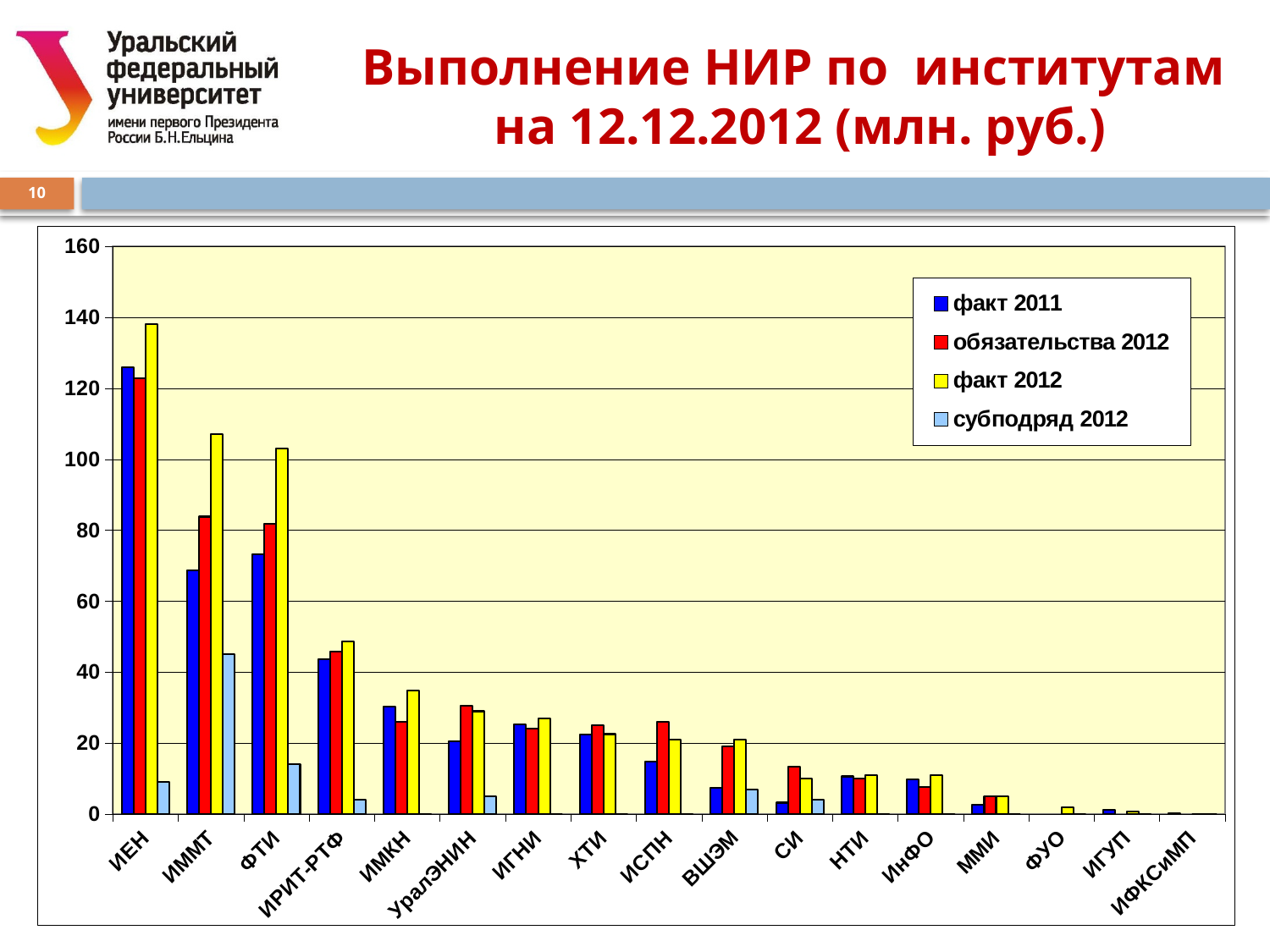
Which institute has the highest value for факт 2011? ИЕН Which institute has the highest value for факт 2012? ИЕН Is the факт 2012 value for ИЕН greater or less than 120? greater What colour represents the факт 2012 series in the legend? yellow Is the субподряд 2012 value for ИММТ greater or less than 40? greater How many series does the legend list? 4 Do the values generally rise or fall moving from left to right along the x axis? fall How many institutes (categories) are shown on the x axis? 17 Is the факт 2011 value for ФТИ greater or less than 80? less Which is larger: the факт 2012 value for ИМКН or the факт 2012 value for ИГНИ? ИМКН What kind of chart is shown on the slide? bar chart